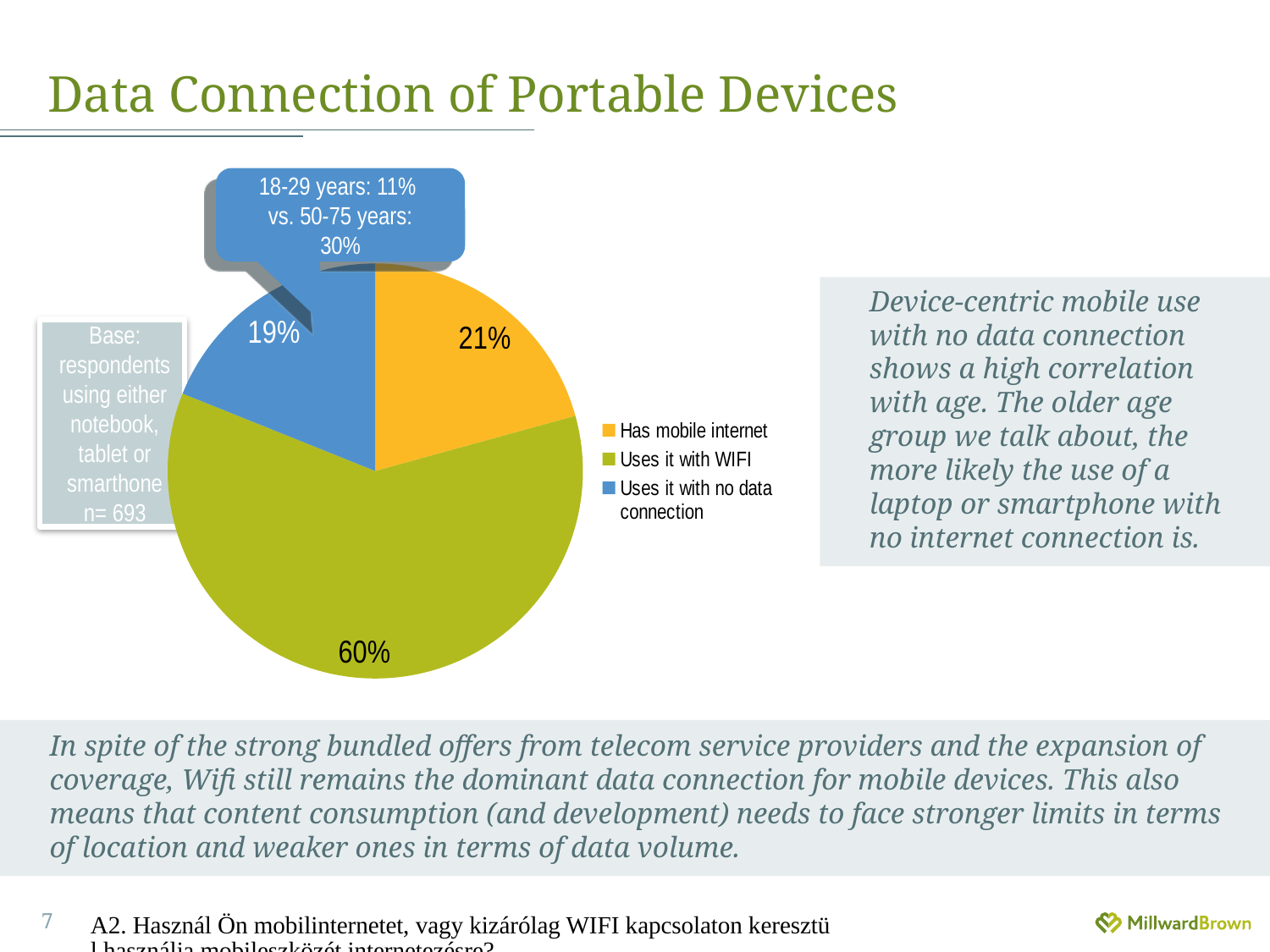
What share of respondents has mobile internet? 21% Which category has the largest share of the pie? Uses it with WIFI Which category has the smallest share of the pie? Uses it with no data connection What share of respondents uses it with no data connection? 19% How many entries does the legend list? 3 What share of respondents uses it with WIFI? 60% What kind of chart is shown on the slide? pie chart How many categories does the pie chart show? 3 What is the base size (n) stated for the chart? n= 693 What is the difference between the share that uses it with WIFI and the share that has mobile internet? 39 percentage points Which is larger: the share that has mobile internet or the share that uses it with no data connection? Has mobile internet What colour is the slice for 'Uses it with WIFI'? green